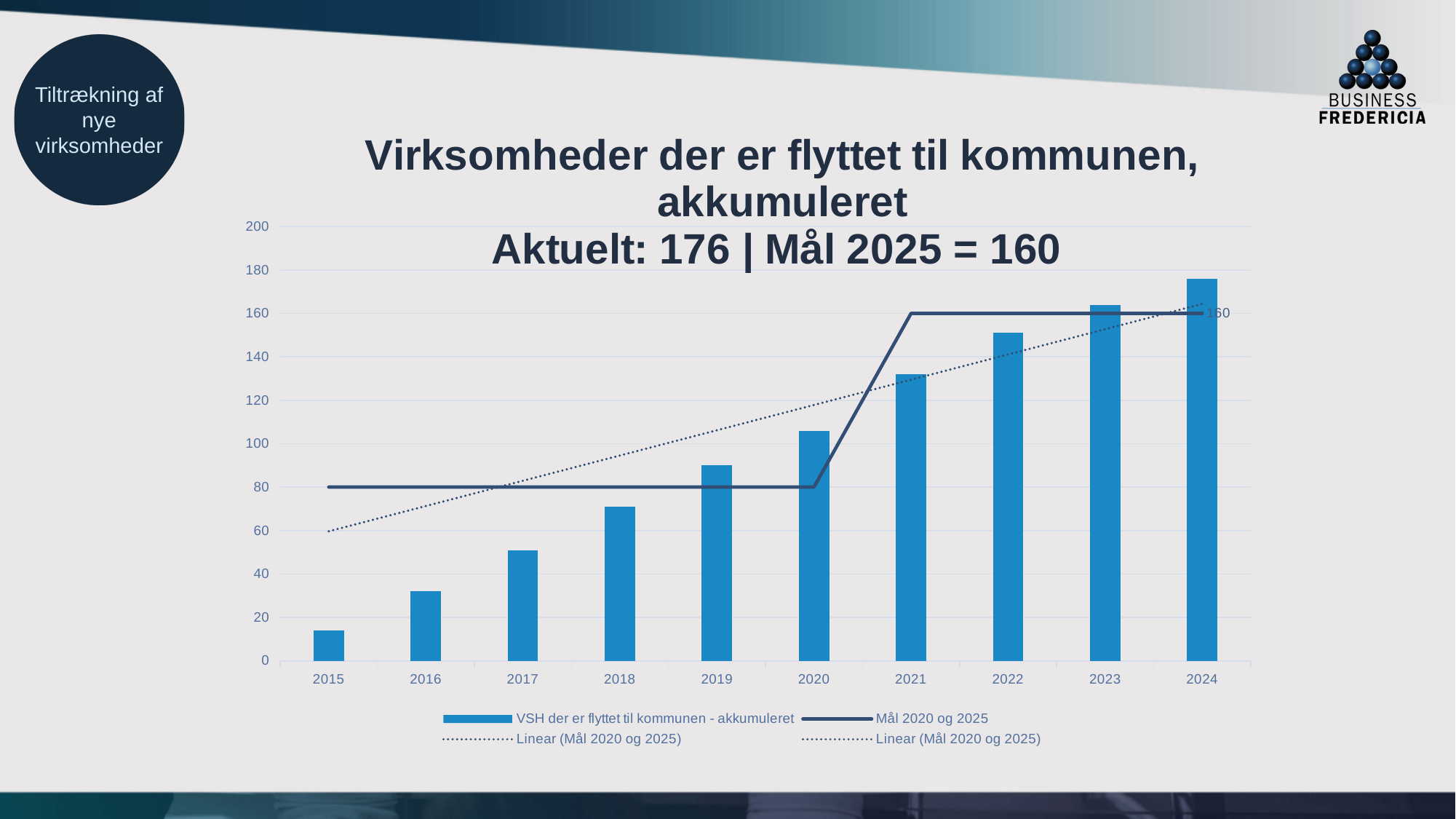
What kind of chart is shown on the slide? combination bar and line chart Which year has the highest bar for 'VSH der er flyttet til kommunen - akkumuleret'? 2024 Is the bar value for 2022 greater or less than 140? greater Do the bar values rise or fall from 2015 to 2024? rise Which year has a larger bar, 2020 or 2023? 2023 Is the bar value for 2015 greater or less than 20? less Which year has the lowest bar for 'VSH der er flyttet til kommunen - akkumuleret'? 2015 What value is labelled on the 'Mål 2020 og 2025' line at 2024? 160 Is the bar value for 2019 greater or less than 80? greater How many series does the chart legend list? 4 How many years are shown on the x axis of the chart? 10 What is the value of the 'Mål 2020 og 2025' line in 2020? 80